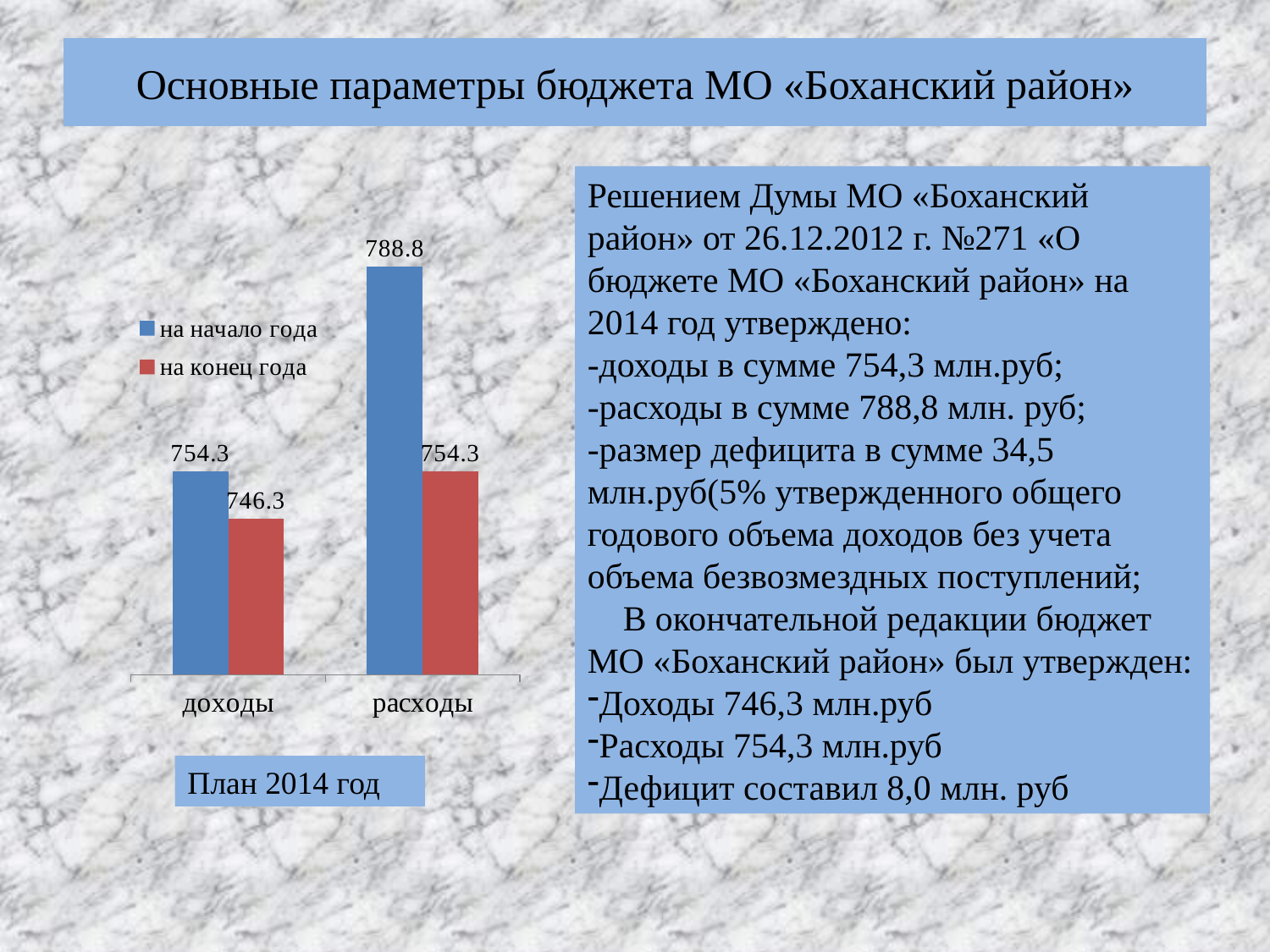
What is the value for расходы in the series на начало года? 788.8 What kind of chart is shown on the slide? bar chart What is the value for доходы in the series на конец года? 746.3 What is the value for доходы in the series на начало года? 754.3 Which bar has the highest value on the chart? расходы, на начало года Which bar has the lowest value on the chart? доходы, на конец года How many series does the chart legend list? 2 What is the value for расходы in the series на конец года? 754.3 Which is larger for расходы: the value на начало года or на конец года? на начало года What is the difference between расходы and доходы in the series на начало года? 34.5 What is the difference between расходы and доходы in the series на конец года? 8.0 How many categories are shown on the x axis of the chart? 2